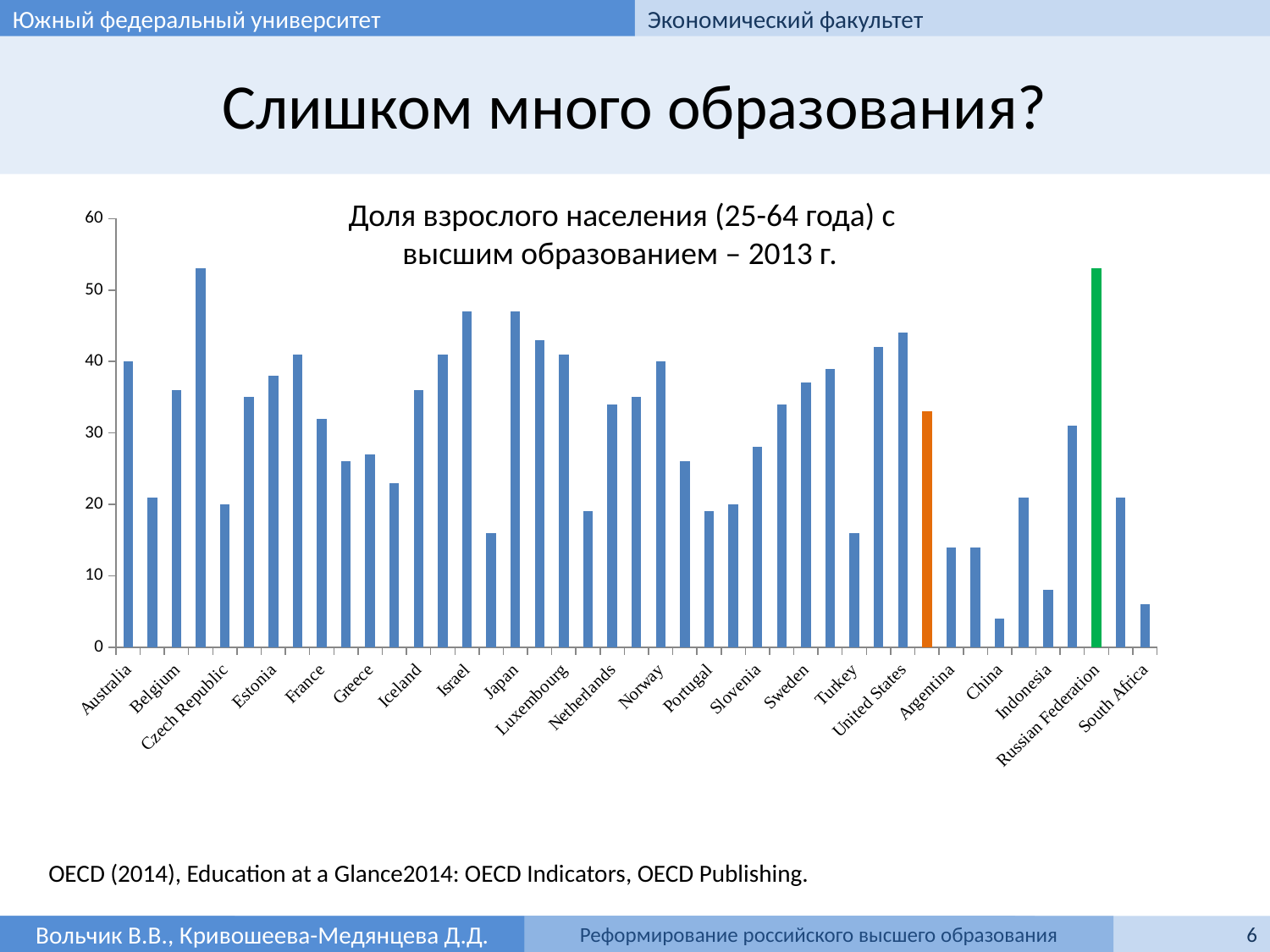
Is the value for Turkey greater or less than 20? less Is the value for Greece greater or less than 30? less What colour is the bar for Russian Federation? green Is the value for United States greater or less than 40? greater What kind of chart is shown on the slide? bar chart Which has the larger value, Russian Federation or Argentina? Russian Federation What is the title of the chart? Доля взрослого населения (25-64 года) с высшим образованием – 2013 г. Which has the larger value, China or Belgium? Belgium